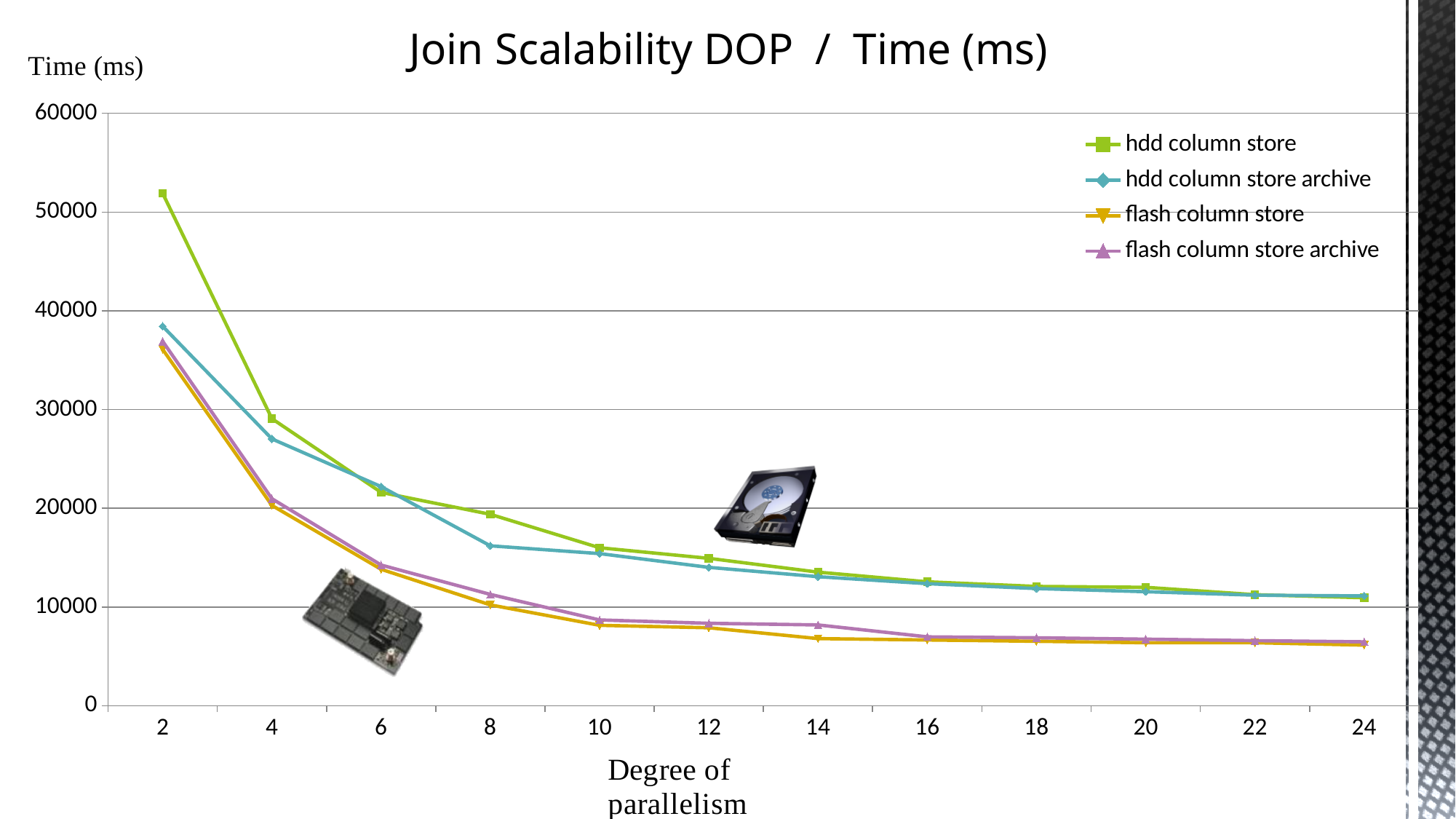
Does the time for hdd column store rise or fall as the degree of parallelism increases? fall Is the time for hdd column store at a degree of parallelism of 2 greater or less than 50000? greater What kind of chart is shown on the slide? line chart Which series has the lowest time at a degree of parallelism of 14? flash column store Is the time for flash column store at a degree of parallelism of 24 greater or less than 10000? less Which series has the highest time at a degree of parallelism of 2? hdd column store Is the time for hdd column store archive at a degree of parallelism of 2 greater or less than 40000? less What is the title of the chart? Join Scalability DOP / Time (ms) How many series does the legend list? 4 At a degree of parallelism of 8, which has the higher time: hdd column store or hdd column store archive? hdd column store How many degree-of-parallelism values are plotted along the x axis? 12 What is the label of the x axis? Degree of parallelism